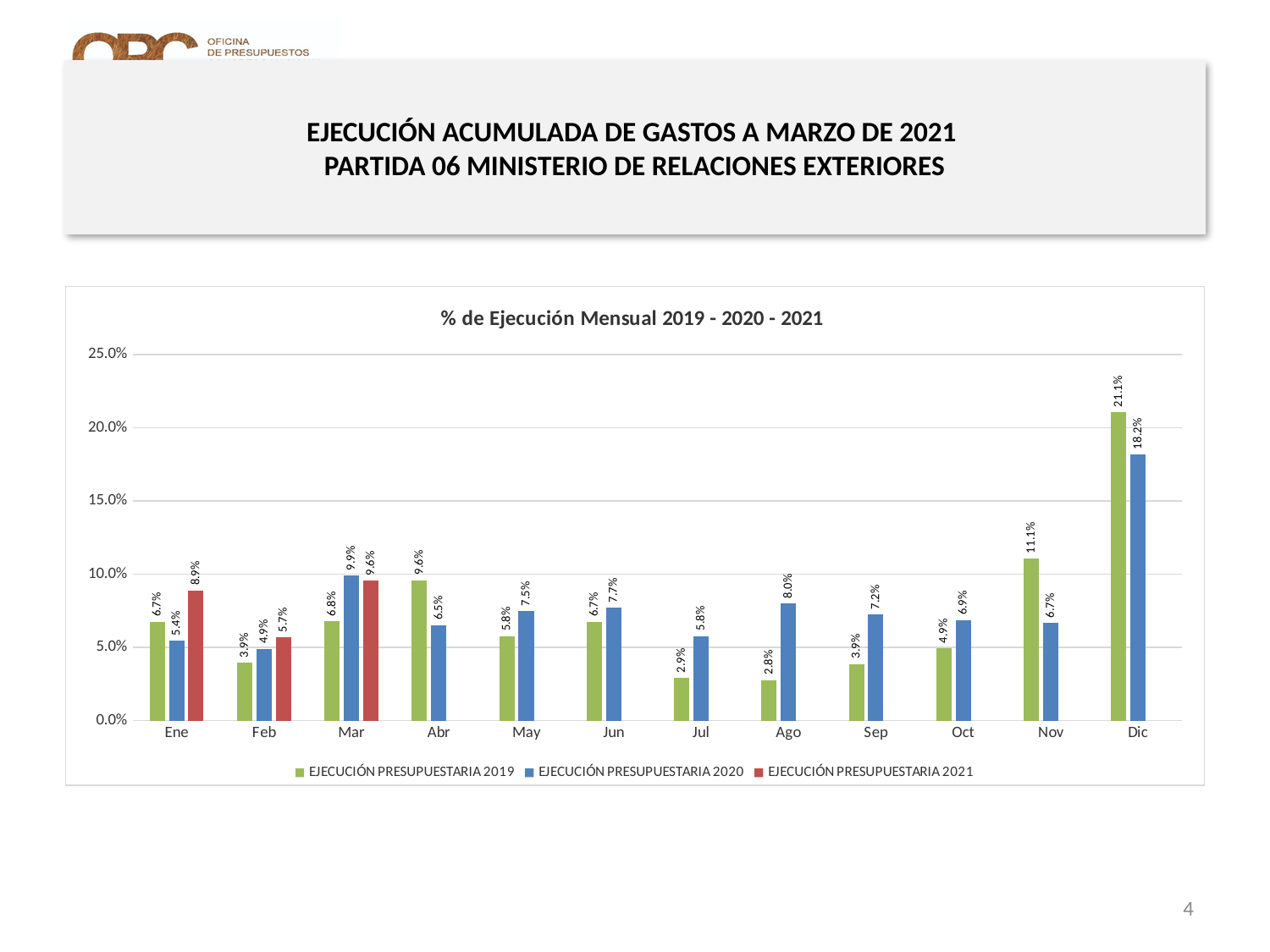
How many months are shown on the x axis? 12 Which month has the lowest value for EJECUCIÓN PRESUPUESTARIA 2019? Ago Which colour represents EJECUCIÓN PRESUPUESTARIA 2021 in the chart? Red What kind of chart is shown on the slide? Bar chart Which is larger in Ago: the EJECUCIÓN PRESUPUESTARIA 2019 value or the EJECUCIÓN PRESUPUESTARIA 2020 value? EJECUCIÓN PRESUPUESTARIA 2020 How many series does the legend list? 3 What is the difference between the 2019 and 2020 values in Dic? 2.9% Which month has the highest value for EJECUCIÓN PRESUPUESTARIA 2019? Dic What is the value for EJECUCIÓN PRESUPUESTARIA 2019 in Nov? 11.1% What is the value for EJECUCIÓN PRESUPUESTARIA 2021 in Ene? 8.9% What is the value for EJECUCIÓN PRESUPUESTARIA 2020 in Mar? 9.9% What is the title of the chart? % de Ejecución Mensual 2019 - 2020 - 2021